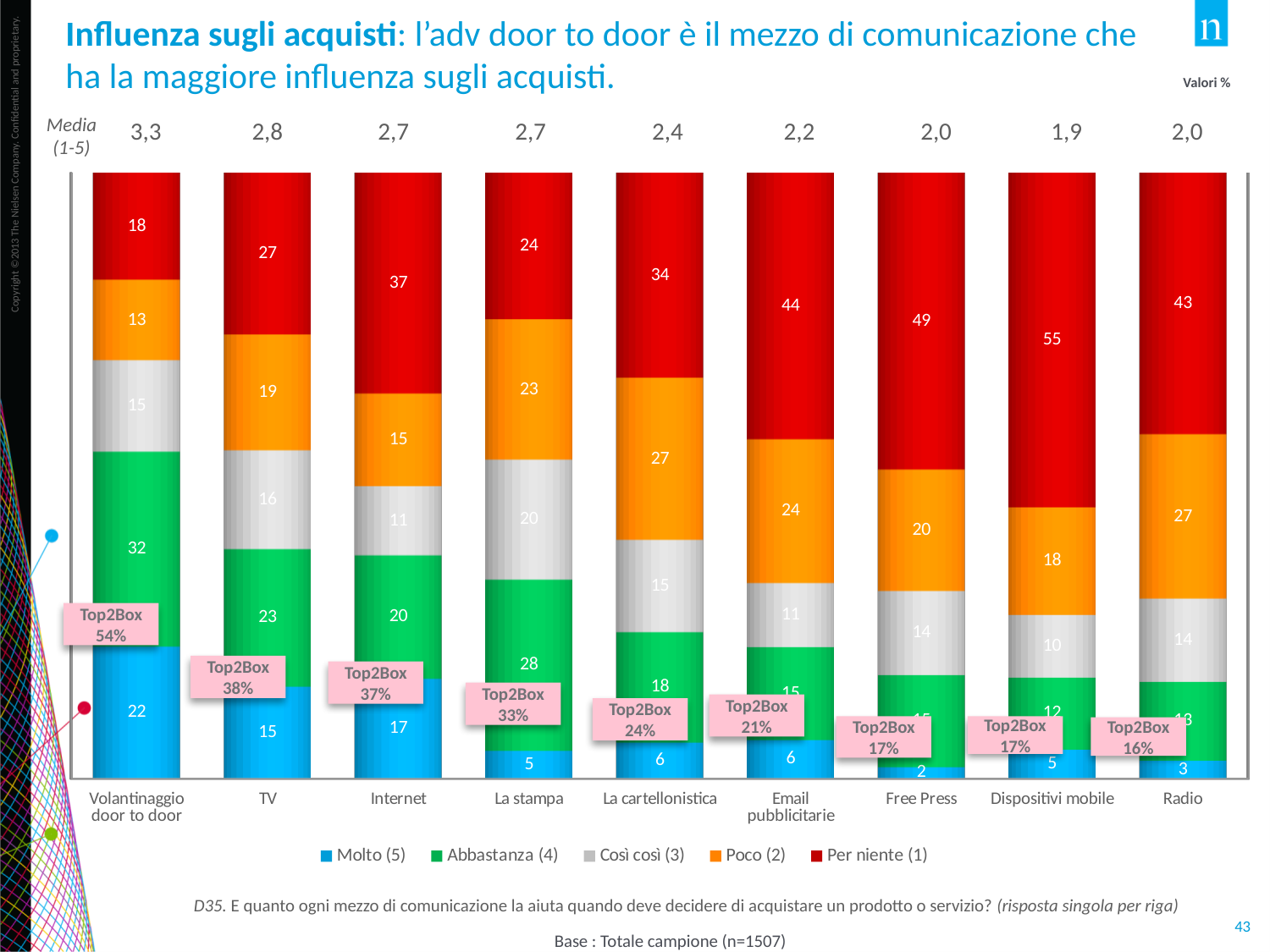
What is the value of 'Per niente (1)' for Dispositivi mobile? 55 Which category has the highest 'Per niente (1)' value? Dispositivi mobile What kind of chart is shown on the slide? Stacked bar chart What is the value of 'Molto (5)' for Volantinaggio door to door? 22 What is the total of the stacked bar for Volantinaggio door to door? 100 What is the Top2Box value shown for TV? 38% How many categories (communication media) are shown on the x axis? 9 What is the Media (1-5) value shown above Volantinaggio door to door? 3,3 What is the difference between the 'Per niente (1)' values for Internet and TV? 10 How many series does the legend list? 5 Which category has the lowest 'Molto (5)' value? Free Press Which has the larger 'Abbastanza (4)' value, Volantinaggio door to door or La stampa? Volantinaggio door to door